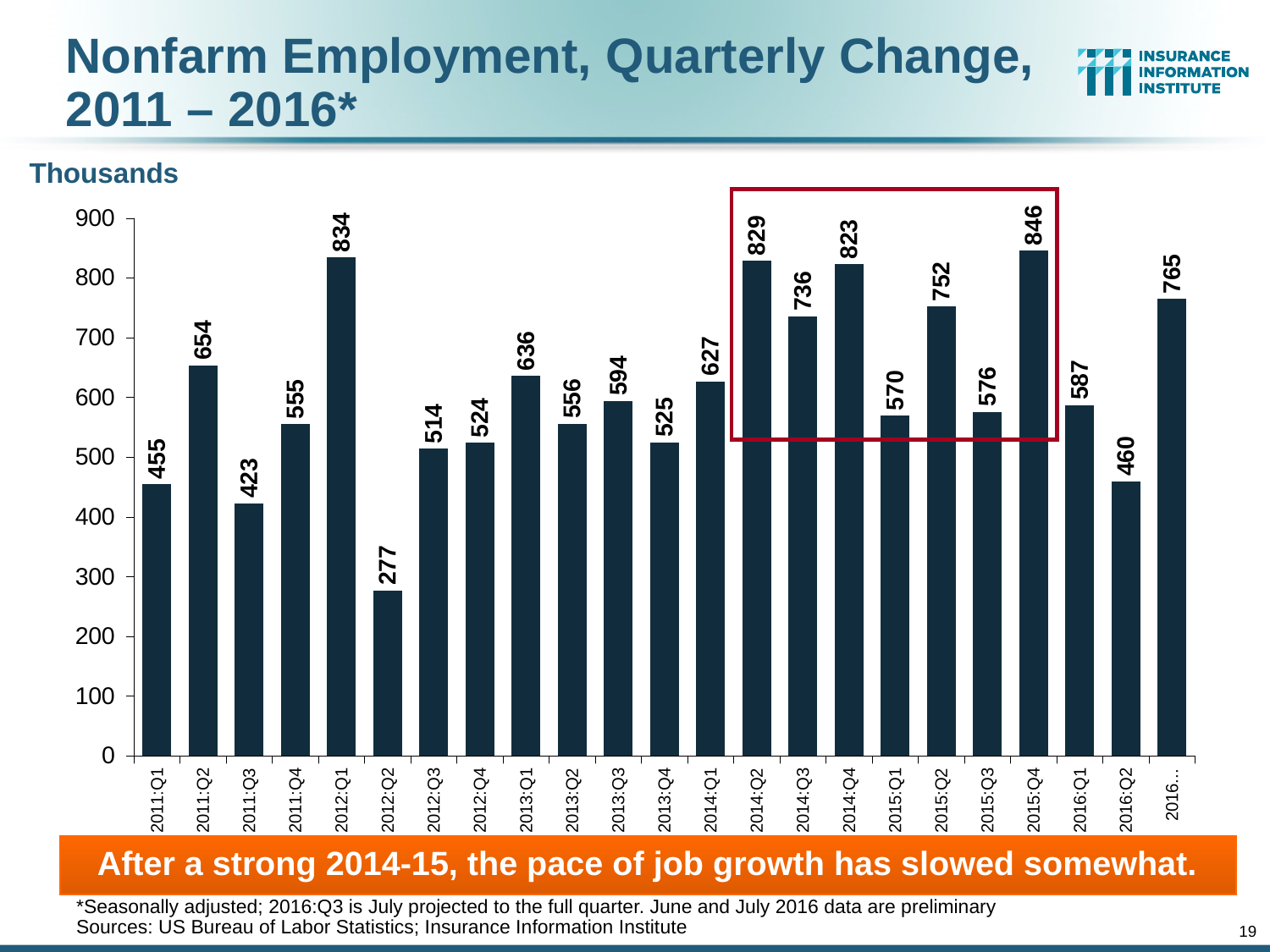
Is the value for 2013:Q3 greater or less than 500? greater Which is larger, the value for 2011:Q2 or the value for 2013:Q1? 2011:Q2 What is the value for 2016:Q2? 460 What is the value for 2015:Q2? 752 What is the difference between the values for 2014:Q2 and 2014:Q3? 93 What kind of chart is shown on the slide? Bar chart What unit is indicated for the values on the chart? Thousands What is the difference between the values for 2015:Q4 and 2016:Q1? 259 How many bars are plotted in the chart? 23 Which quarter has the highest value? 2015:Q4 Which quarter has the lowest value? 2012:Q2 What is the value for 2012:Q1? 834